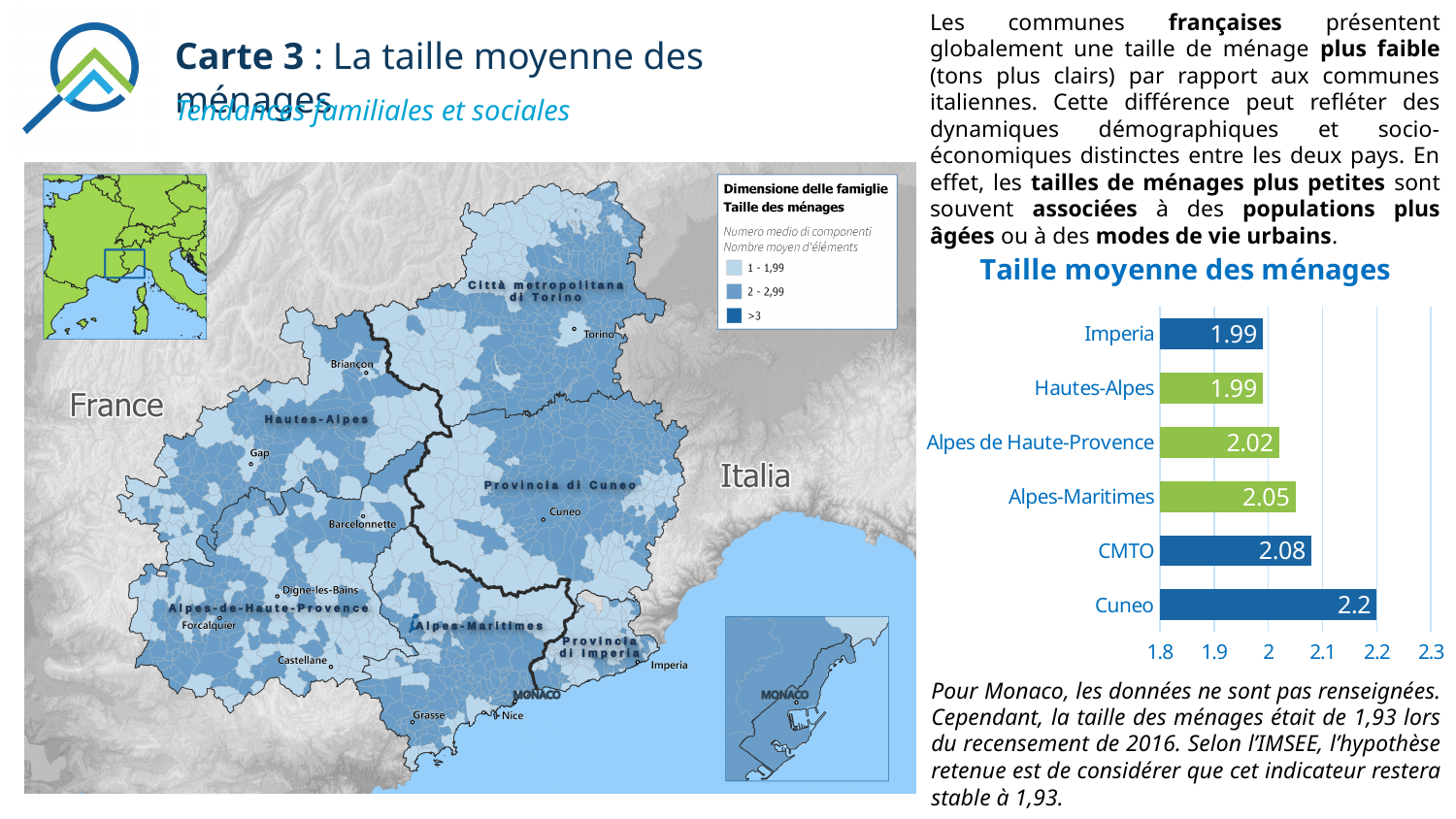
In the chart 'Taille moyenne des ménages', what is the value for Cuneo? 2.2 How many categories are shown in the chart 'Taille moyenne des ménages'? 6 In the chart 'Taille moyenne des ménages', which is larger, the value for CMTO or the value for Alpes de Haute-Provence? CMTO In the chart 'Taille moyenne des ménages', what is the difference between the values for CMTO and Alpes-Maritimes? 0.03 In the chart 'Taille moyenne des ménages', what is the value for CMTO? 2.08 In the chart 'Taille moyenne des ménages', what is the value for Alpes de Haute-Provence? 2.02 In the chart 'Taille moyenne des ménages', what is the value for Alpes-Maritimes? 2.05 In the chart 'Taille moyenne des ménages', is the value for Cuneo greater or less than 2.1? greater In the chart 'Taille moyenne des ménages', what colour is the bar for Hautes-Alpes? Green What kind of chart is 'Taille moyenne des ménages'? Bar chart In the chart 'Taille moyenne des ménages', which category has the highest value? Cuneo In the chart 'Taille moyenne des ménages', what is the difference between the values for Cuneo and Imperia? 0.21